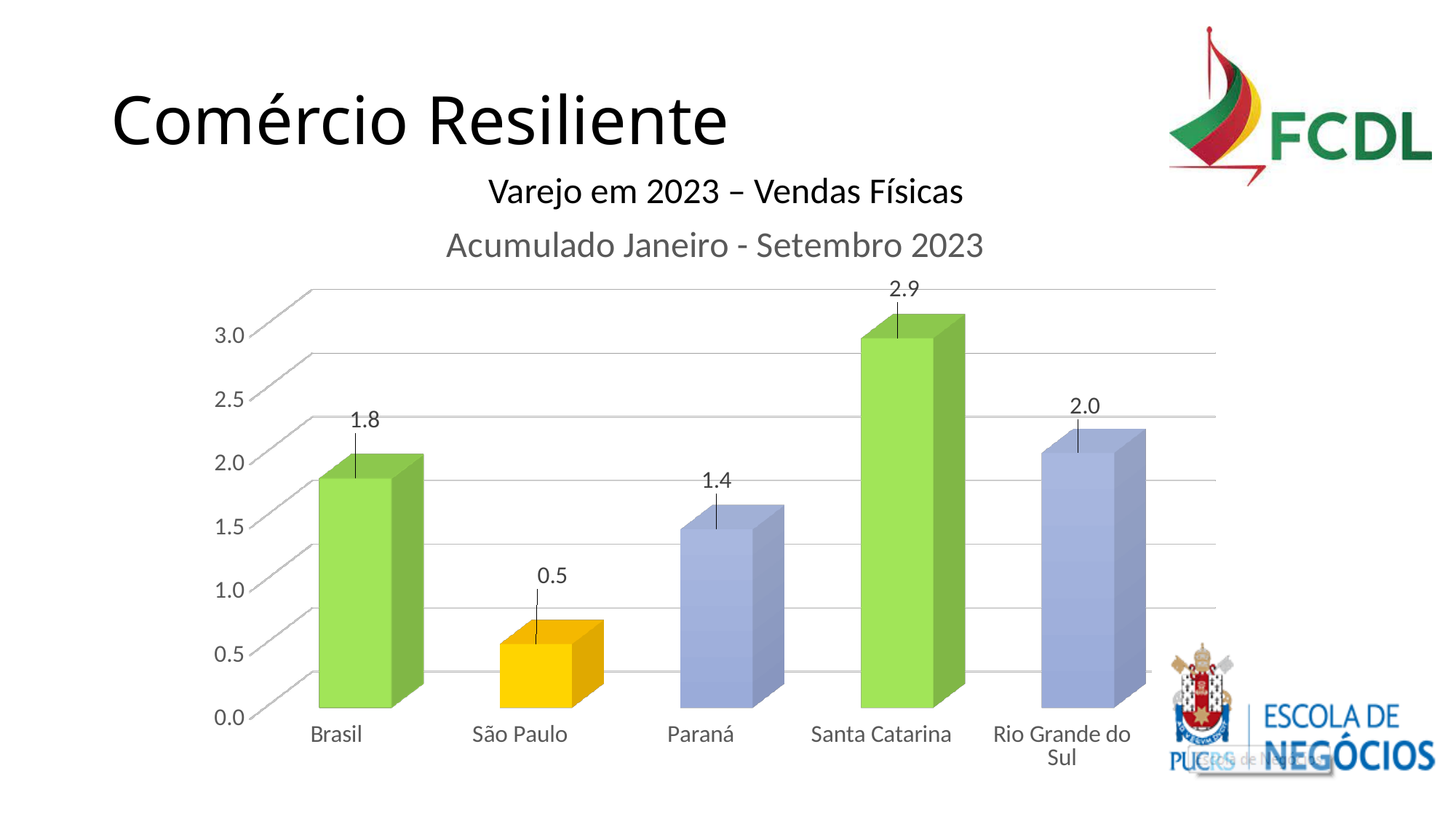
What kind of chart is shown on the slide? bar chart What is the title of the chart? Acumulado Janeiro - Setembro 2023 What is the value for Paraná? 1.4 What is the value for Rio Grande do Sul? 2.0 Which category has the lowest value? São Paulo What is the value for São Paulo? 0.5 What is the difference between the values for Santa Catarina and Brasil? 1.1 Is the value for Santa Catarina greater or less than 2.5? greater What is the value for Brasil? 1.8 Which is larger, the value for Paraná or the value for Rio Grande do Sul? Rio Grande do Sul How many categories are shown on the x axis? 5 Which category has the highest value? Santa Catarina